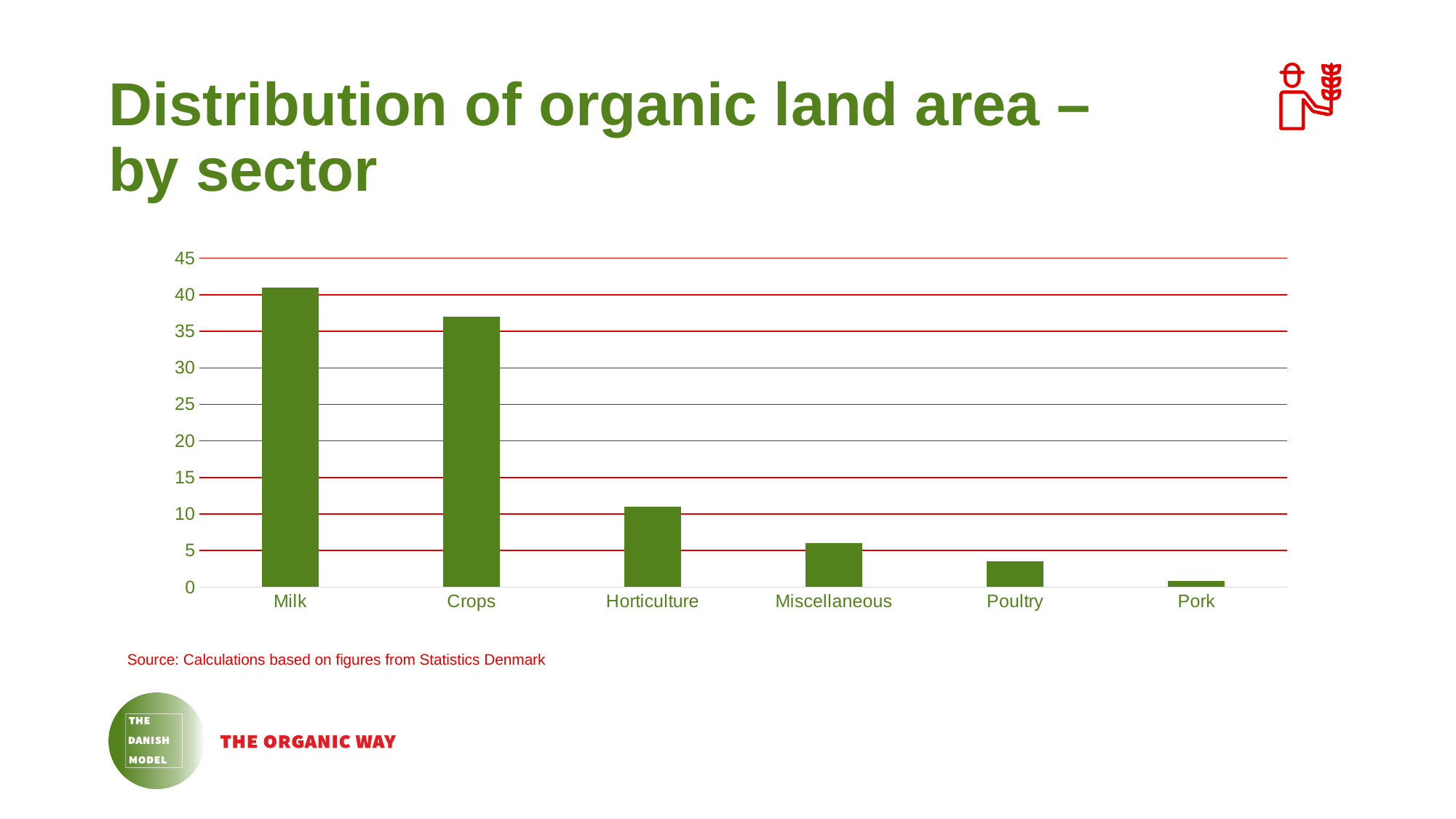
Is the value for Crops greater or less than 40? less Which has a larger value, Miscellaneous or Poultry? Miscellaneous What kind of chart is shown on the slide? bar chart Do the bar values rise or fall from left to right along the x axis? fall Which sector has the lowest value in the chart? Pork How many sectors are shown on the x axis of the chart? 6 Which has a larger value, Crops or Horticulture? Crops Is the value for Horticulture greater or less than 15? less Which sector has the highest value in the chart? Milk What is the title of the slide containing the chart? Distribution of organic land area – by sector Is the value for Milk greater or less than 35? greater